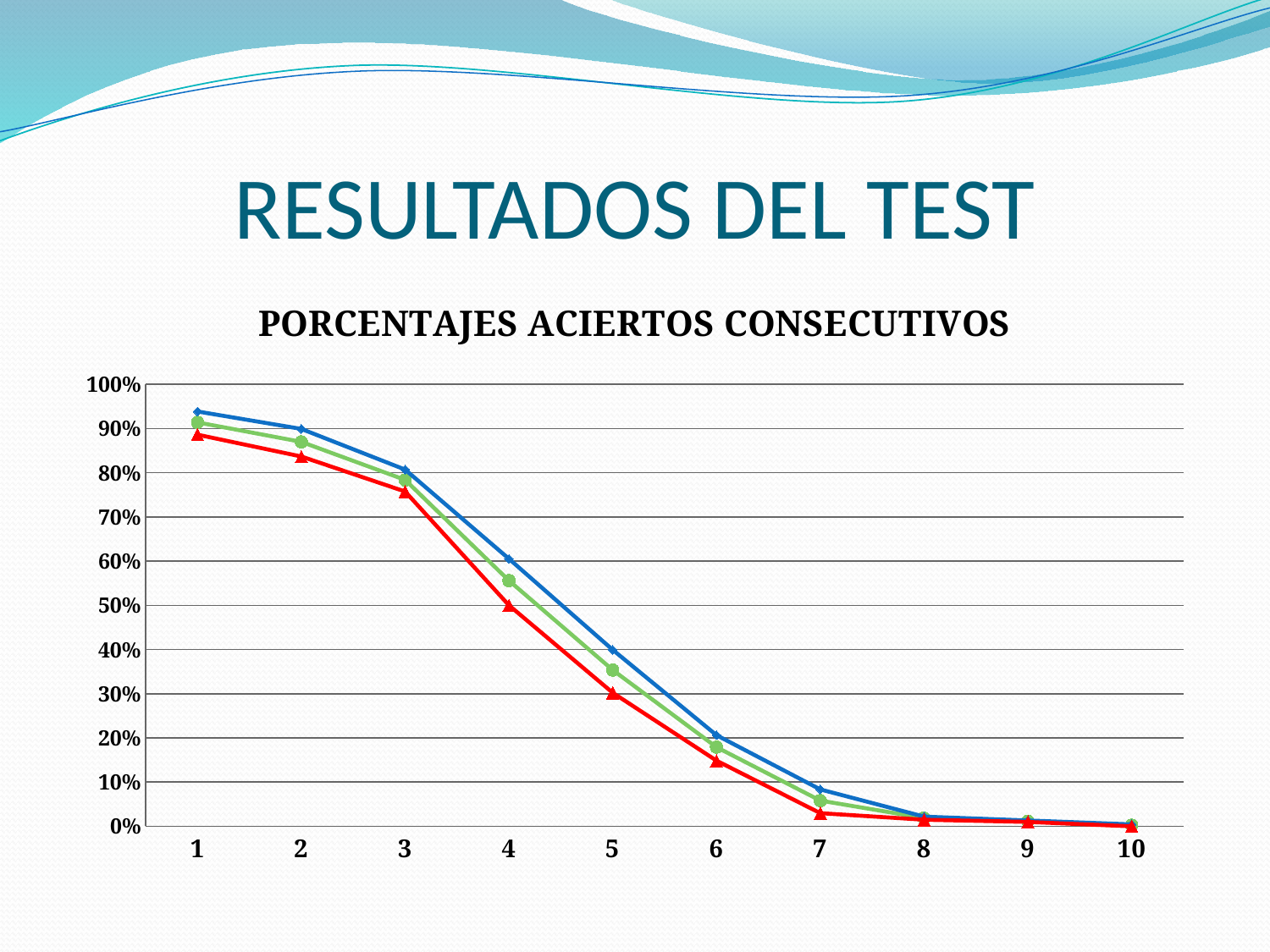
What is the title of the chart? PORCENTAJES ACIERTOS CONSECUTIVOS Do the values of the lines rise or fall as the x axis goes from 1 to 10? fall How many points are labelled along the x axis of the chart? 10 Is the value of the blue line at x = 7 greater or less than 10%? less How many lines are plotted on the chart? 3 Is the value of the red line at x = 1 greater or less than 90%? less What kind of chart is shown on the slide? line chart At which x value does the blue line reach its highest value? 1 Is the value of the green line at x = 5 greater or less than 30%? greater At x = 5, which line has the higher value, the blue line or the red line? blue line